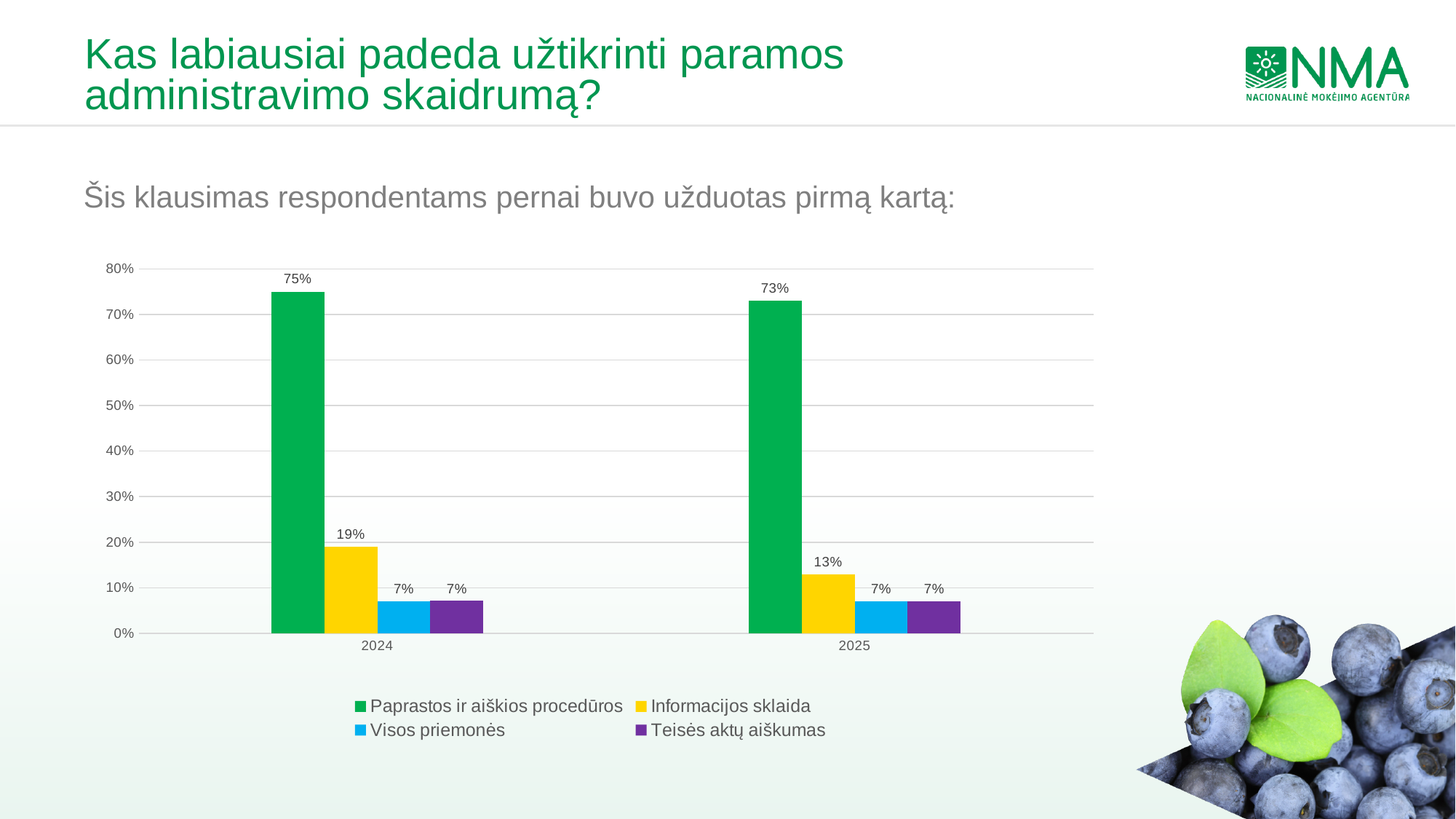
Is the value for "Informacijos sklaida" in 2024 greater or less than 10%? greater What is the value for "Paprastos ir aiškios procedūros" in 2024? 75% What is the difference between the "Informacijos sklaida" values for 2024 and 2025? 6% How many series does the legend list? 4 What kind of chart is shown on the slide? Bar chart What is the value for "Teisės aktų aiškumas" in 2025? 7% What is the value for "Visos priemonės" in 2024? 7% What is the difference between "Paprastos ir aiškios procedūros" and "Informacijos sklaida" in 2024? 56% Which series has the highest value in 2025? Paprastos ir aiškios procedūros Which is larger: "Paprastos ir aiškios procedūros" in 2024 or in 2025? 2024 How many year categories are shown on the x axis? 2 What is the value for "Informacijos sklaida" in 2025? 13%